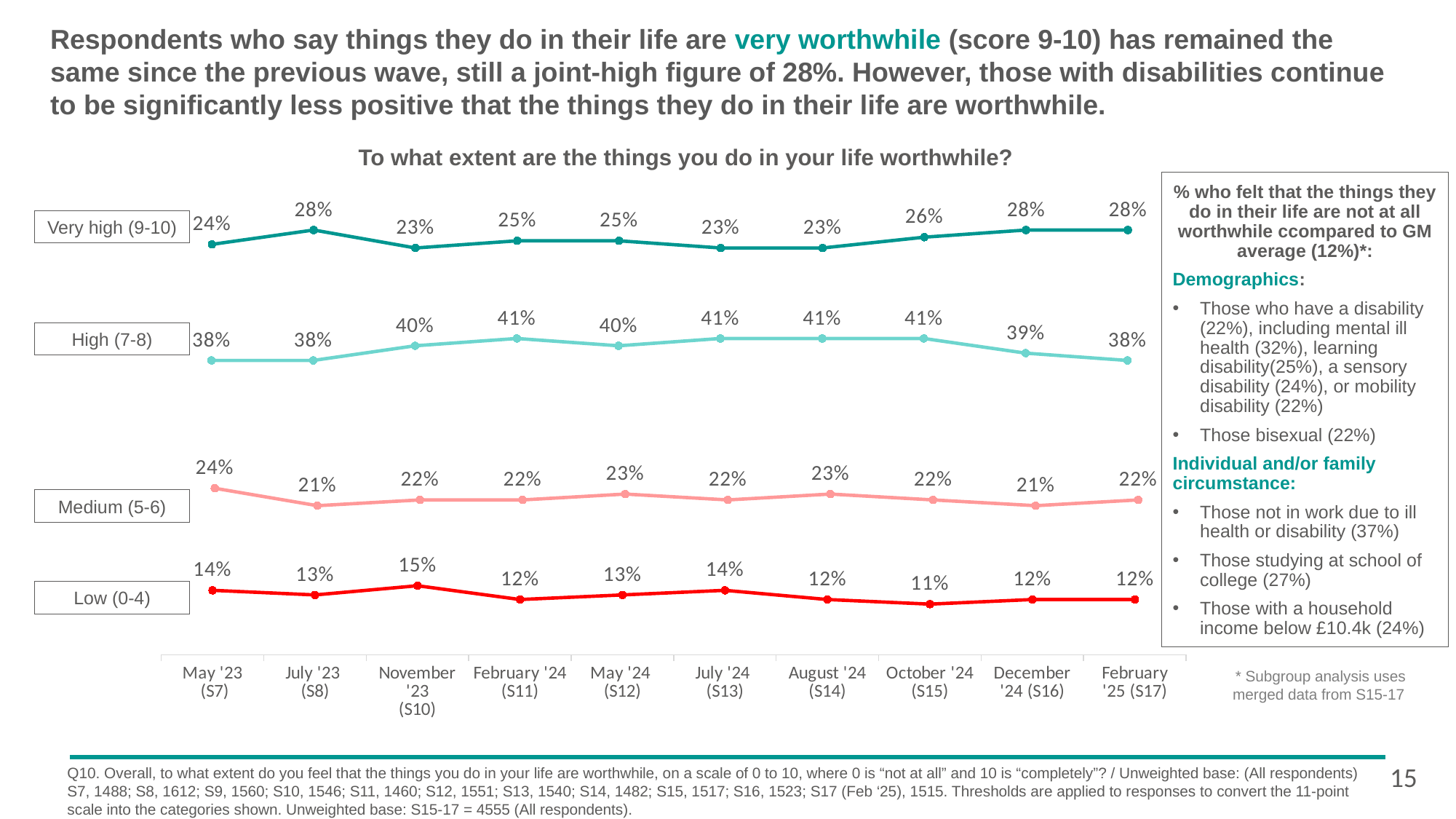
In which wave is the Low (0-4) series at its highest value? November '23 (S10) How many survey waves are shown on the x axis? 10 What is the value for Low (0-4) in November '23 (S10)? 15% What type of chart is shown on the slide? Line chart In which wave is the Low (0-4) series at its lowest value? October '24 (S15) What is the value for Medium (5-6) in May '23 (S7)? 24% What is the value for High (7-8) in February '24 (S11)? 41% What is the difference between the High (7-8) and Very high (9-10) values in February '25 (S17)? 10 percentage points How many series are plotted on the chart? 4 What is the value for Very high (9-10) in February '25 (S17)? 28% What is the title of the chart? To what extent are the things you do in your life worthwhile? Which is larger in May '23 (S7): the Very high (9-10) value or the Medium (5-6) value? They are equal (24%)